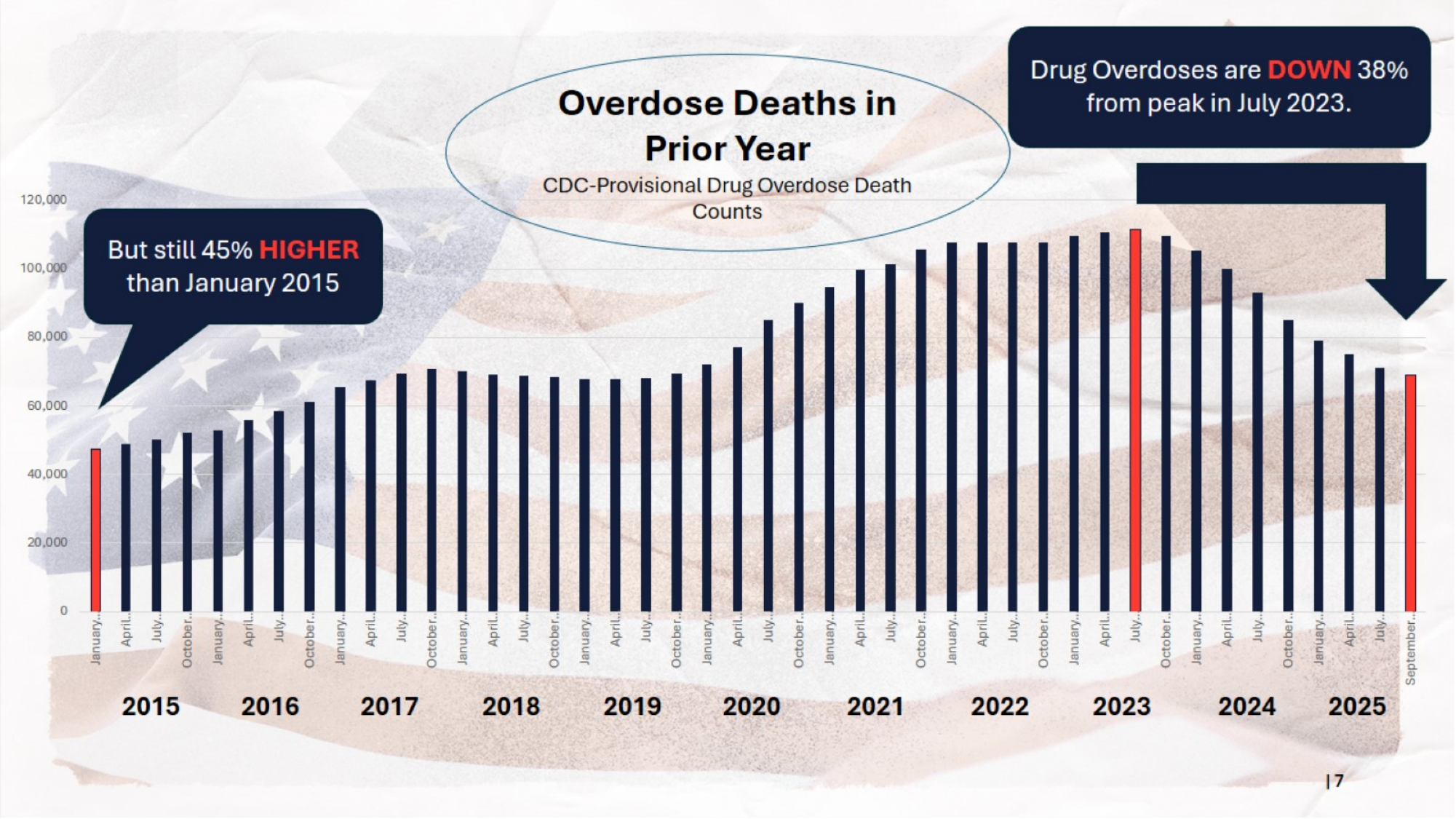
Is the value for July 2023 greater or less than 100,000? greater Which month has the highest bar in the chart? July 2023 How many years are labeled along the x axis? 11 Is the value for September 2025 greater or less than 80,000? less Do the values rise or fall from July 2023 to September 2025? Fall Which month has the lowest bar in the chart? January 2015 Is the value for January 2019 greater or less than 60,000? greater What kind of chart is shown on the slide? Bar chart Which is larger, the value for January 2015 or the value for September 2025? September 2025 What is the subtitle shown under the chart title? CDC-Provisional Drug Overdose Death Counts What is the title of the chart? Overdose Deaths in Prior Year